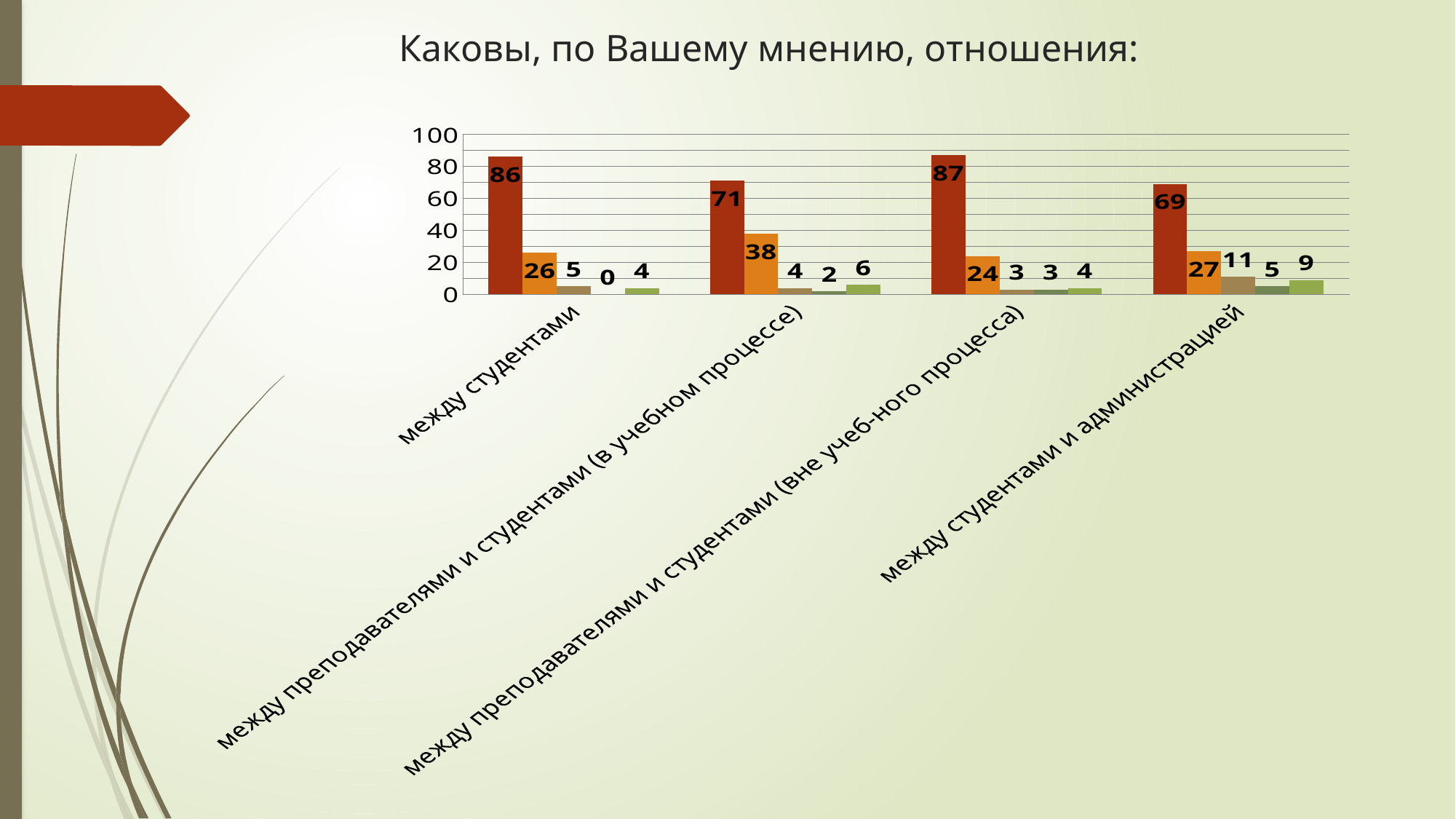
What kind of chart is shown on the slide? bar chart What is the title of the slide above the chart? Каковы, по Вашему мнению, отношения: What is the value of the fourth (dark green) bar for the category "между студентами"? 0 What is the value of the light green (last) bar for the category "между студентами и администрацией"? 9 How many categories are shown on the x axis of the chart? 4 Which is larger: the orange bar for "между студентами" or the orange bar for "между преподавателями и студентами (в учебном процессе)"? между преподавателями и студентами (в учебном процессе) Which category has the highest dark red bar? между преподавателями и студентами (вне учеб-ного процесса) What is the difference between the dark red bar values for "между студентами" and "между студентами и администрацией"? 17 What is the value of the tallest (dark red) bar for the category "между студентами"? 86 What is the value of the orange bar for the category "между преподавателями и студентами (в учебном процессе)"? 38 Which category has the lowest dark red bar? между студентами и администрацией What is the value of the dark red bar for the category "между студентами и администрацией"? 69